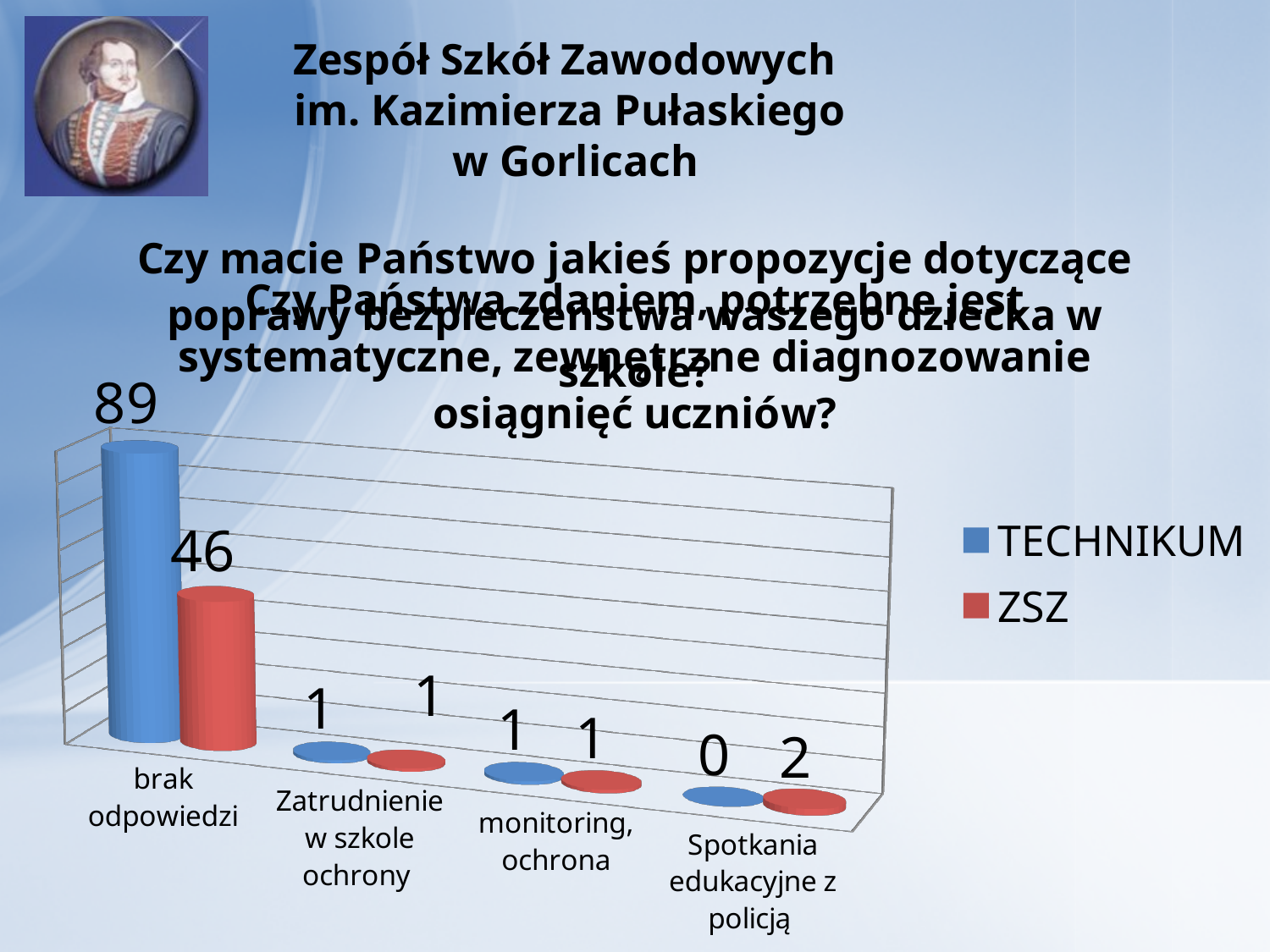
Which category has the highest TECHNIKUM value? brak odpowiedzi What is the TECHNIKUM value for "Spotkania edukacyjne z policją"? 0 What is the ZSZ value for "brak odpowiedzi"? 46 Which category has the lowest TECHNIKUM value? Spotkania edukacyjne z policją What kind of chart is shown on the slide? bar chart What is the TECHNIKUM value for "monitoring, ochrona"? 1 How many categories are shown on the x axis? 4 What is the ZSZ value for "Spotkania edukacyjne z policją"? 2 What is the TECHNIKUM value for "brak odpowiedzi"? 89 What is the difference between the TECHNIKUM and ZSZ values for "brak odpowiedzi"? 43 How many series does the legend list? 2 For "Spotkania edukacyjne z policją", which series has the larger value, TECHNIKUM or ZSZ? ZSZ